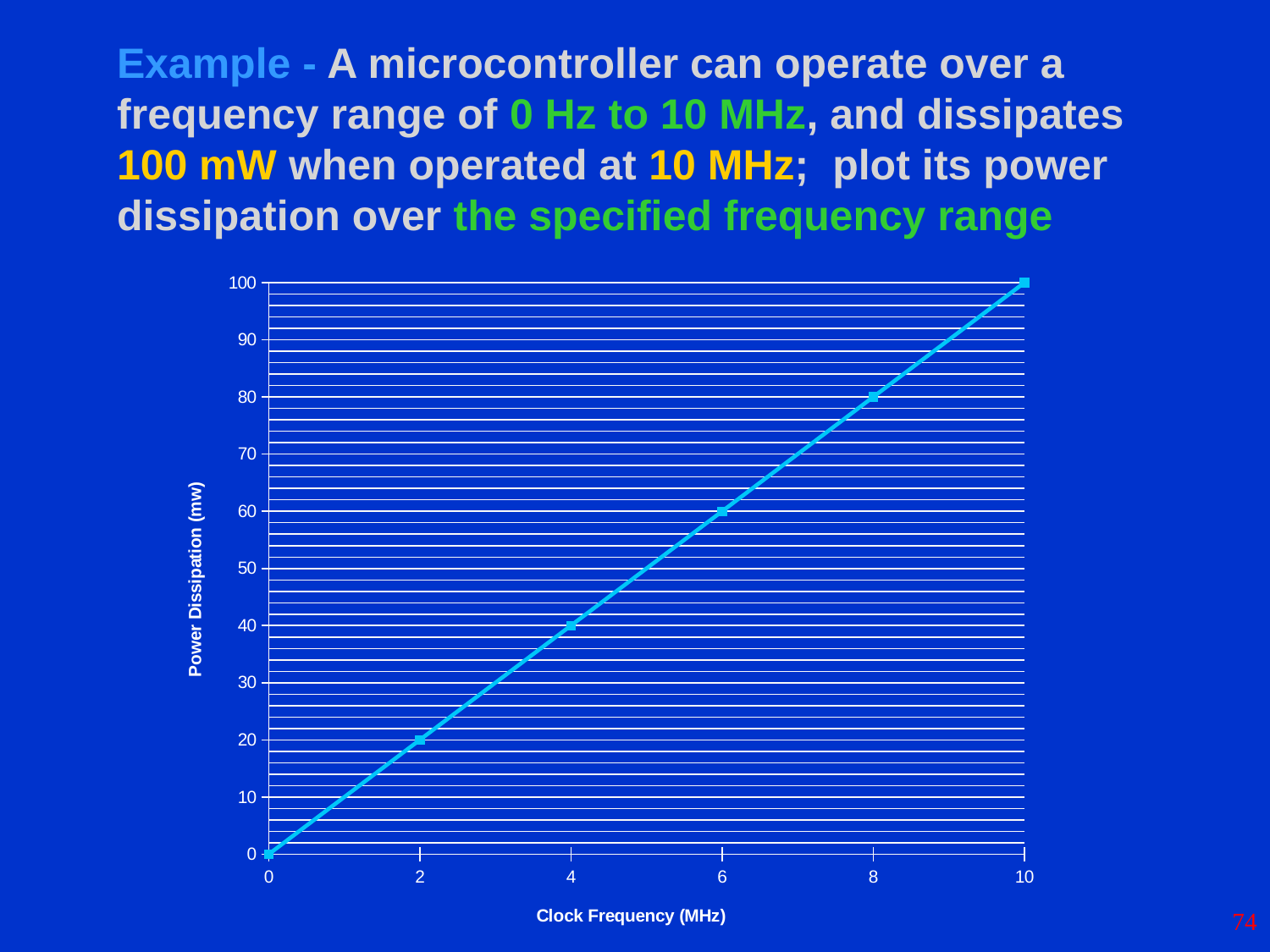
What kind of chart is shown on the slide? line chart What is the power dissipation at a clock frequency of 0 MHz? 0 At which clock frequency is the power dissipation lowest? 0 At which clock frequency is the power dissipation highest? 10 What is the power dissipation at a clock frequency of 10 MHz? 100 How many data points are plotted on the line? 6 Which has the larger power dissipation, 6 MHz or 8 MHz? 8 MHz What is the power dissipation at a clock frequency of 6 MHz? 60 What is the label of the x axis? Clock Frequency (MHz) Does the power dissipation rise or fall as clock frequency increases? rise What is the power dissipation at a clock frequency of 4 MHz? 40 What is the difference in power dissipation between 8 MHz and 2 MHz? 60